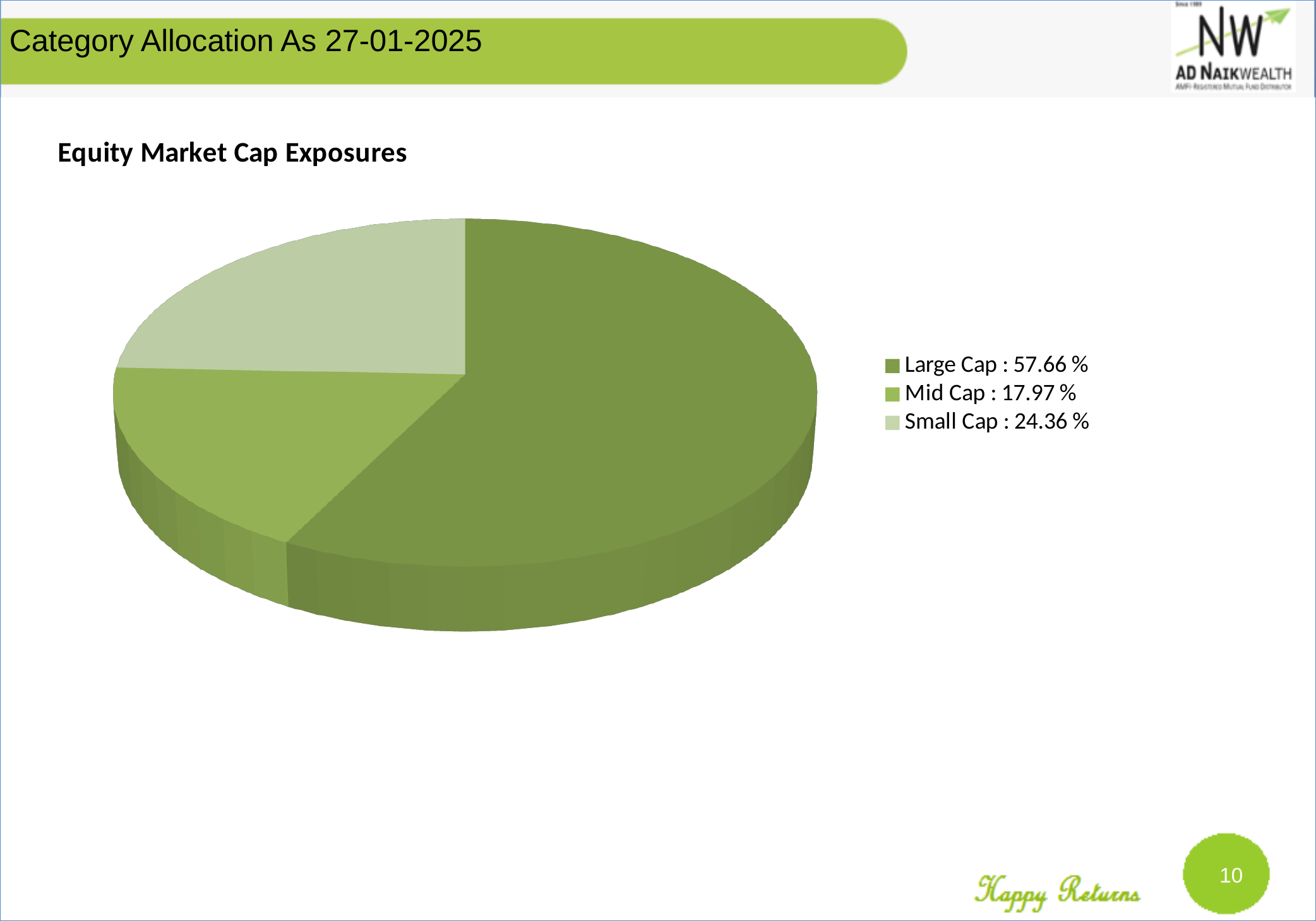
What is the value for Small Cap? 24.36 % How many categories does the pie chart show? 3 What is the difference between the Small Cap and Mid Cap values? 6.39 % Which category is shown in the lightest green colour? Small Cap Which is larger, Small Cap or Mid Cap? Small Cap What is the difference between the Large Cap and Small Cap values? 33.30 % What is the value for Mid Cap? 17.97 % Which category has the largest share of the pie? Large Cap What kind of chart is shown on the slide? Pie chart What is the value for Large Cap? 57.66 % What is the title of the chart? Equity Market Cap Exposures Which category has the smallest share of the pie? Mid Cap